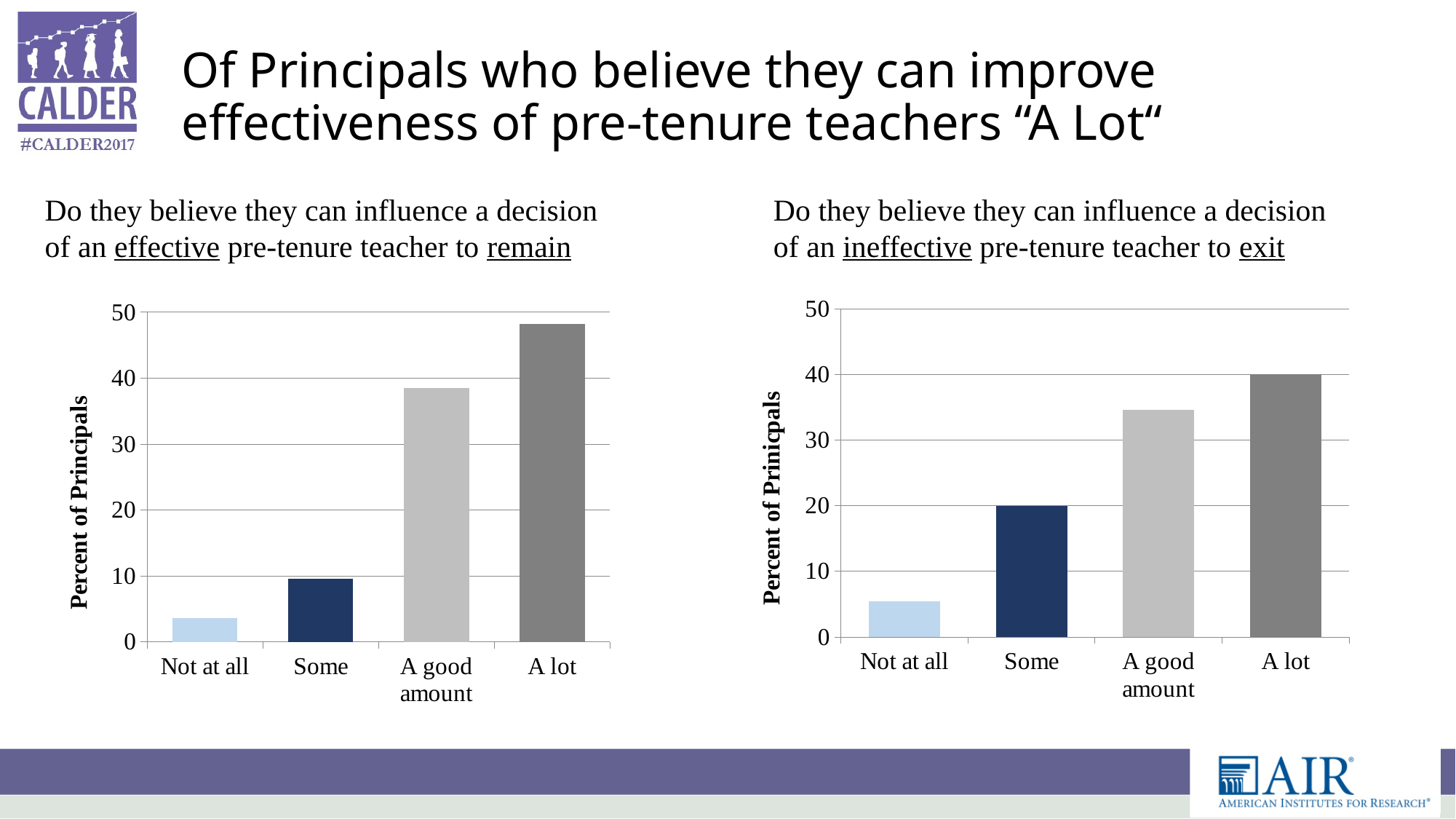
What kind of chart is the left chart (effective pre-tenure teacher to remain)? bar chart On the right chart (ineffective pre-tenure teacher to exit), which is larger, the value for Some or the value for Not at all? Some On the right chart (ineffective pre-tenure teacher to exit), which category has the lowest value? Not at all On the right chart (ineffective pre-tenure teacher to exit), which category has the highest value? A lot On the right chart (ineffective pre-tenure teacher to exit), do the values rise or fall from Not at all to A lot? rise How many categories are shown on the left chart (effective pre-tenure teacher to remain)? 4 On the left chart (effective pre-tenure teacher to remain), which category has the highest value? A lot What is the y-axis title of the left chart (effective pre-tenure teacher to remain)? Percent of Principals On the right chart (ineffective pre-tenure teacher to exit), is the value for A good amount greater or less than 30? greater On the left chart (effective pre-tenure teacher to remain), which category has the lowest value? Not at all On the left chart (effective pre-tenure teacher to remain), is the value for A good amount greater or less than 30? greater